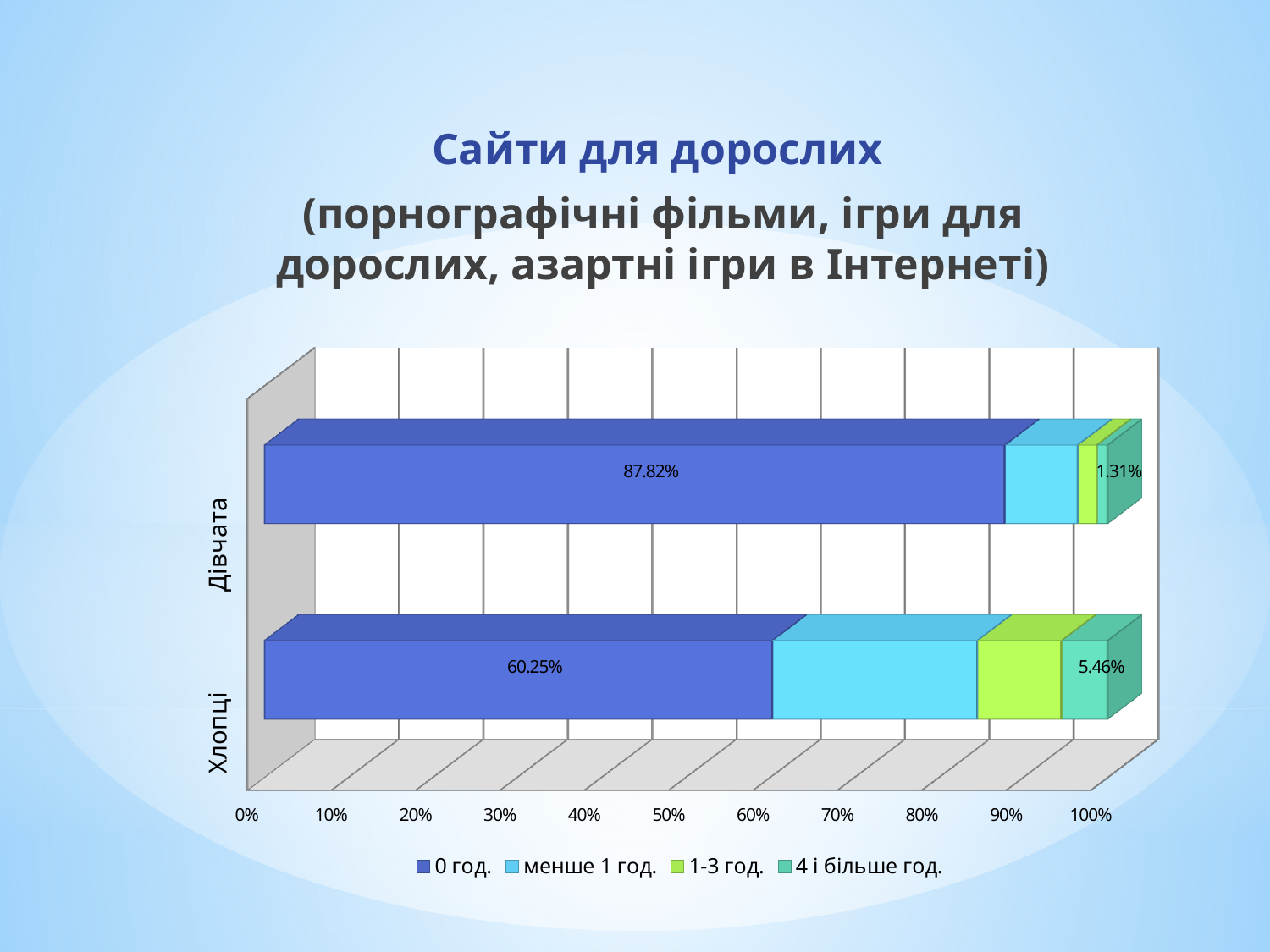
What is the value for 0 год. for Дівчата? 87.82% What is the value for 4 і більше год. for Хлопці? 5.46% How many series does the legend list? 4 What is the first entry in the chart legend? 0 год. What is the value for 4 і більше год. for Дівчата? 1.31% Which group has the larger value for 0 год., Дівчата or Хлопці? Дівчата What is the difference between the 4 і більше год. values for Хлопці and Дівчата? 4.15% Is the value for менше 1 год. for Хлопці greater or less than 10%? greater How many categories (groups) are shown on the chart? 2 What is the value for 0 год. for Хлопці? 60.25% What is the difference between the 0 год. values for Дівчата and Хлопці? 27.57% What kind of chart is shown on the slide? Stacked bar chart